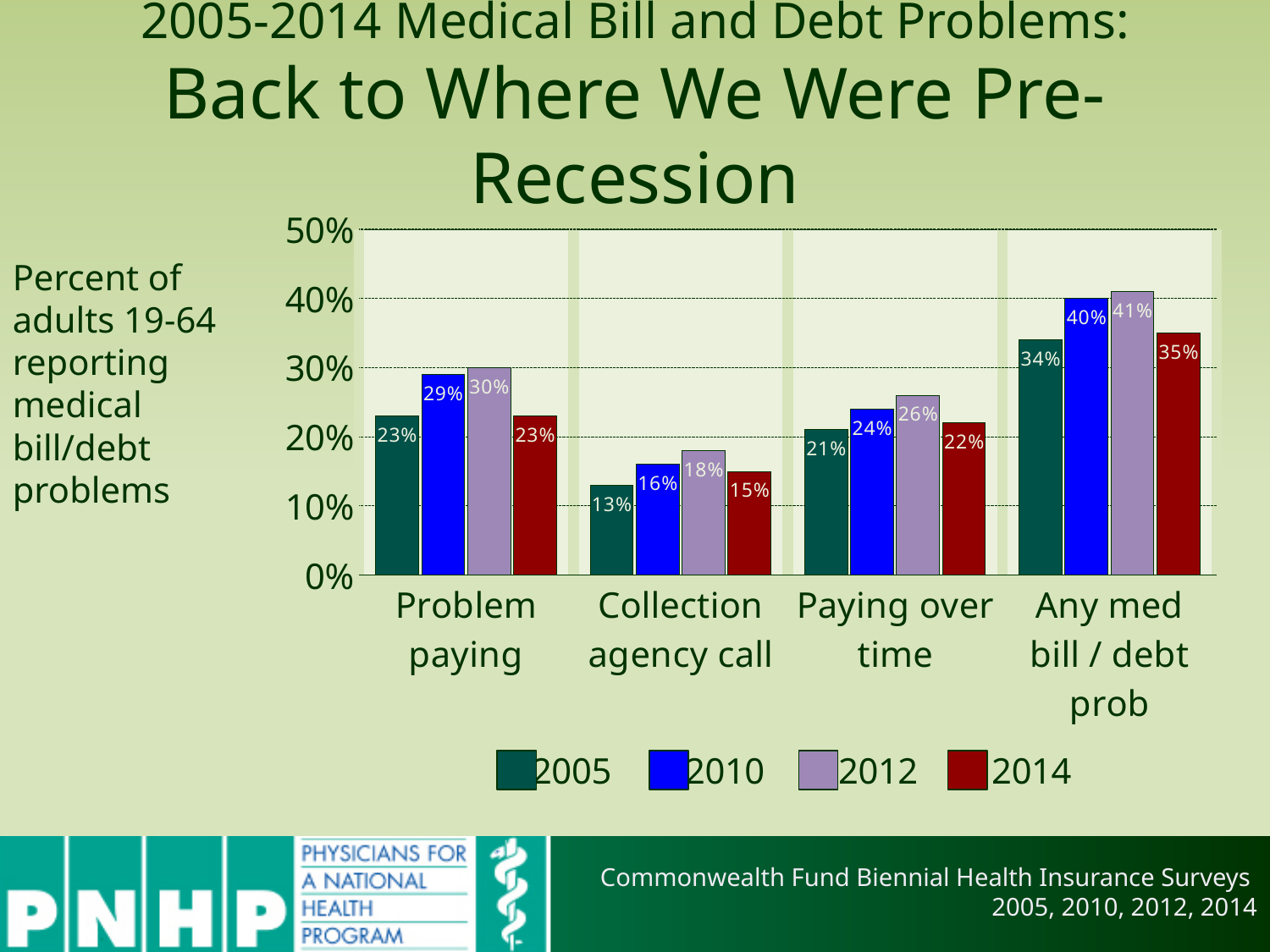
Which category has the lowest value for 2014? Collection agency call What kind of chart is shown on the slide? Bar chart What is the value for 2014 in the Paying over time category? 22% What is the value for 2012 in the Any med bill / debt prob category? 41% Which category has the highest value for 2010? Any med bill / debt prob What is the difference between the 2012 and 2014 values in the Problem paying category? 7% Is the value for 2005 in the Any med bill / debt prob category greater or less than 30%? greater What is the value for 2005 in the Collection agency call category? 13% Which year does the dark red series in the legend represent? 2014 How many series does the legend list? 4 Which is larger in the Paying over time category, the 2010 value or the 2012 value? 2012 How many categories are shown on the x axis? 4